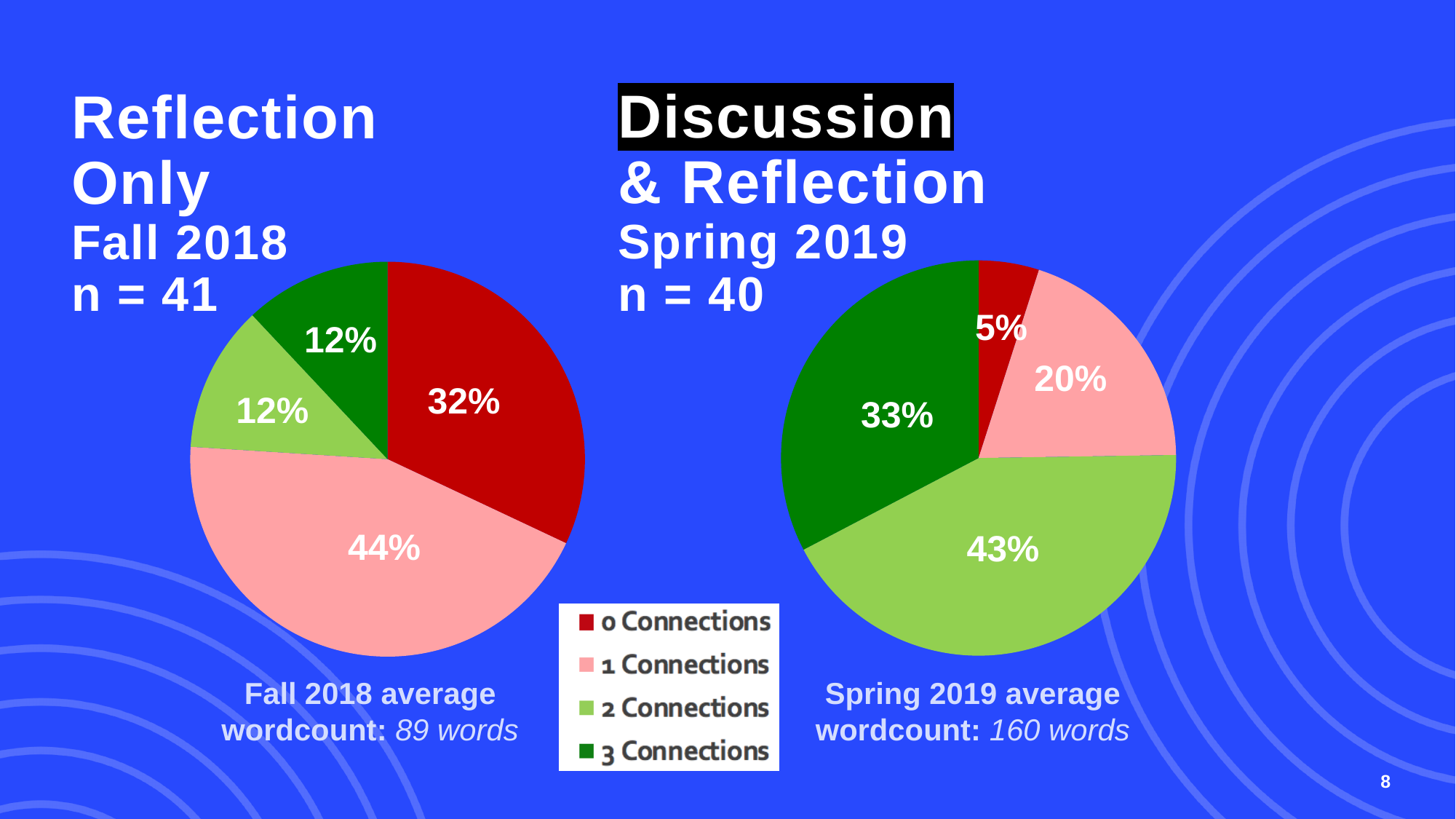
What type of chart is used on this slide? Pie chart In the Reflection Only (Fall 2018) pie chart, what share of the pie is 1 Connections? 44% In the Discussion & Reflection (Spring 2019) pie chart, what share of the pie is 2 Connections? 43% In the Reflection Only (Fall 2018) pie chart, what share of the pie is 0 Connections? 32% Which is larger: the 0 Connections share in the Fall 2018 chart or the 0 Connections share in the Spring 2019 chart? Fall 2018 In the Reflection Only (Fall 2018) pie chart, which category has the largest slice? 1 Connections In the Discussion & Reflection (Spring 2019) pie chart, which category has the largest slice? 2 Connections What is the difference between the 3 Connections share in the Spring 2019 chart and the 3 Connections share in the Fall 2018 chart? 21 percentage points In the Discussion & Reflection (Spring 2019) pie chart, which category has the smallest slice? 0 Connections How many entries does the legend list? 4